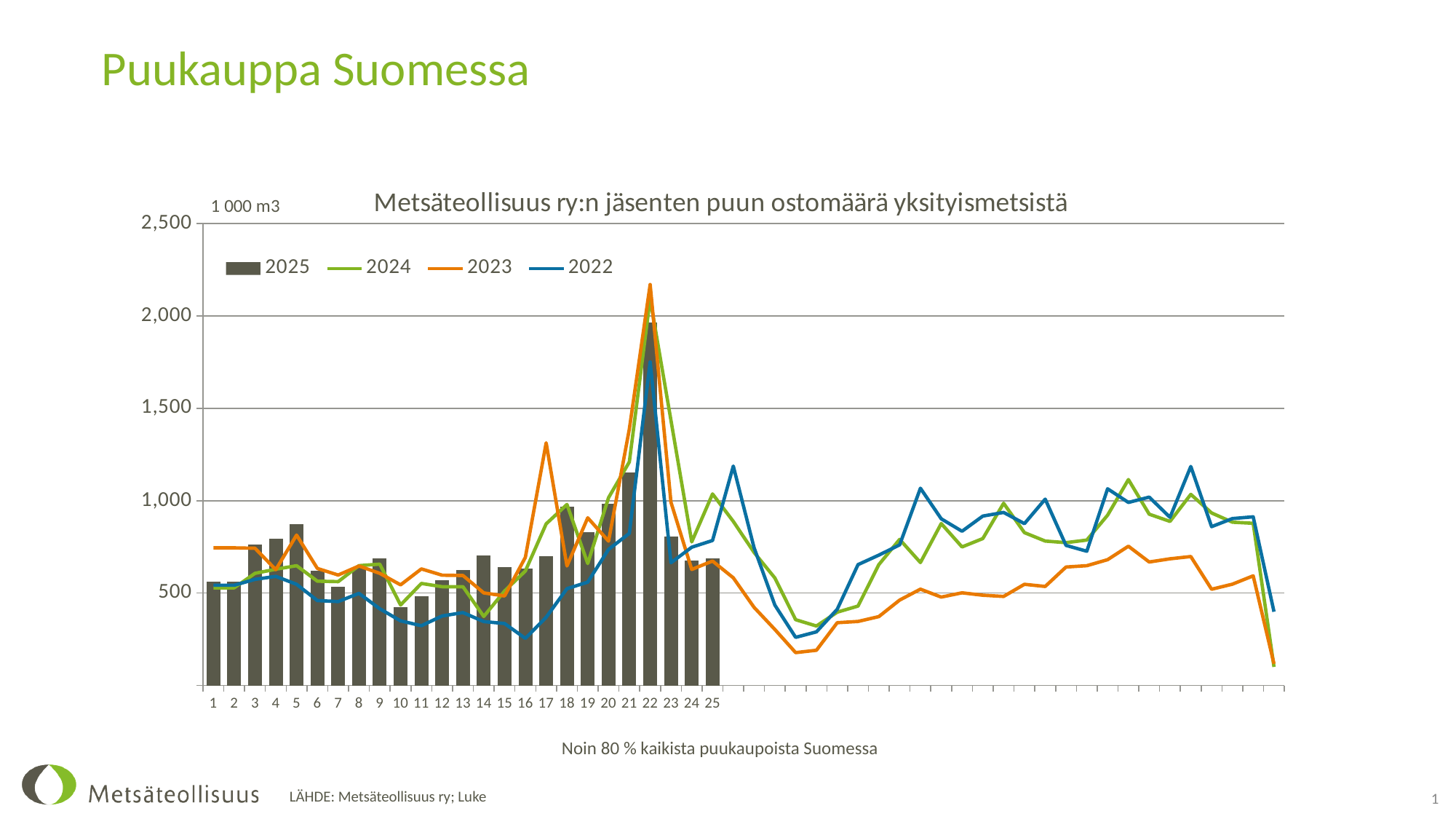
What unit is shown above the vertical axis of the chart? 1 000 m3 Is the 2023 value at week 22 greater or less than 2,000? greater How many bars are plotted for the 2025 series? 25 Do the 2025 bars rise or fall from week 19 to week 22? Rise Is the 2022 value at week 16 greater or less than 500? less How many series does the legend list? 4 What kind of chart is shown on the slide? A combined bar and line chart Which week has the highest 2025 bar? 22 Is the 2025 value for week 21 greater or less than 1,000? greater Which 2025 bar is taller, week 5 or week 10? Week 5